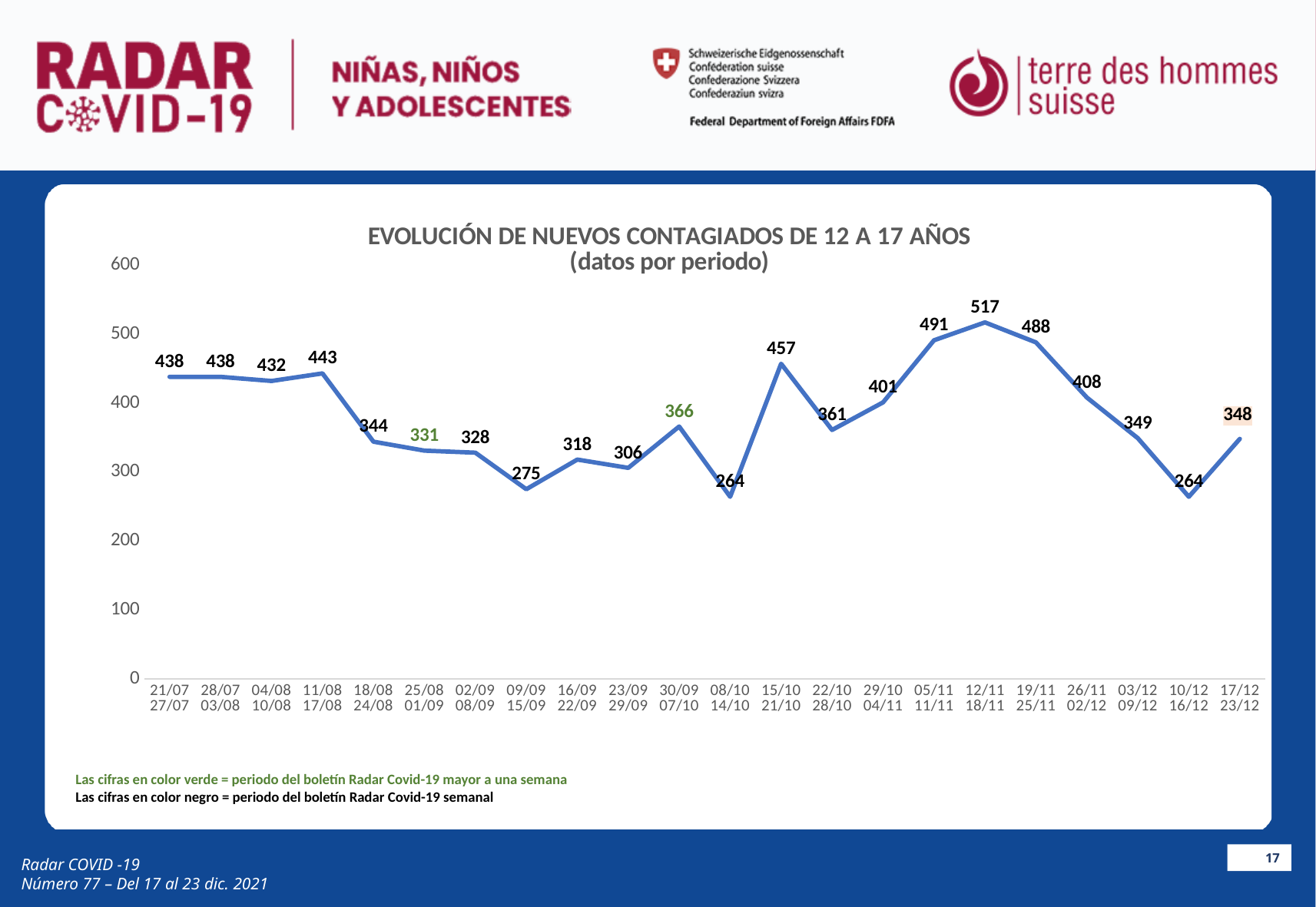
What is the value for the period 15/10–21/10? 457 What kind of chart is shown on the slide? Line chart What is the value for the period 12/11–18/11? 517 Do the values rise or fall from 12/11–18/11 to 10/12–16/12? Fall What is the lowest value plotted on the chart? 264 What is the difference between the values for 12/11–18/11 and 19/11–25/11? 29 Which period has the highest value? 12/11–18/11 Which is larger, the value for 05/11–11/11 or the value for 15/10–21/10? 05/11–11/11 Which two data labels are shown in green on the chart? 331 and 366 What is the difference between the values for 10/12–16/12 and 17/12–23/12? 84 How many periods (data points) are plotted on the chart? 22 What is the value for the period 17/12–23/12? 348